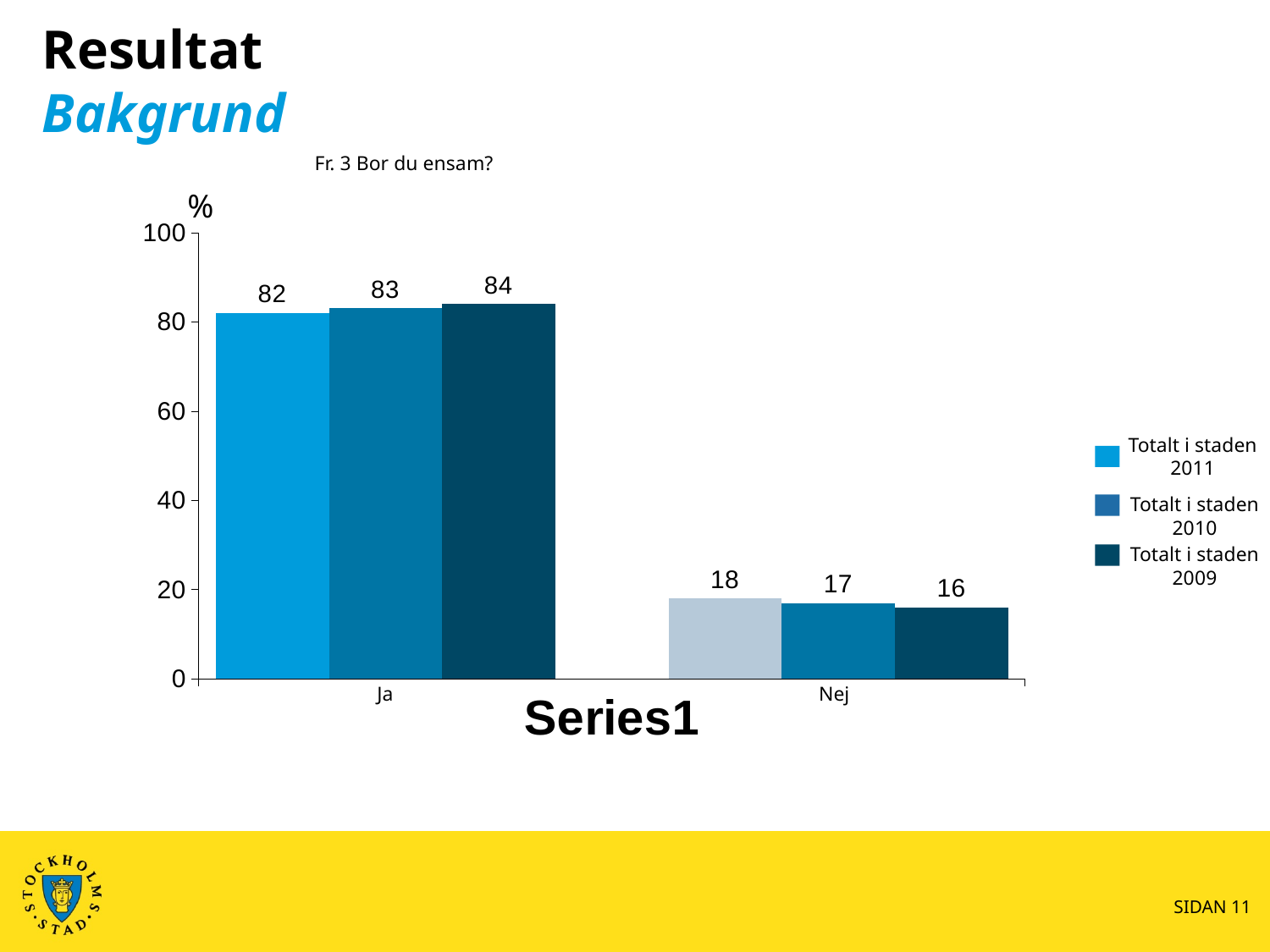
How many categories are shown on the x axis? 2 What is the title of the chart? Fr. 3 Bor du ensam? Which is larger: the "Ja" value for "Totalt i staden 2011" or the "Ja" value for "Totalt i staden 2009"? Totalt i staden 2009 What is the value for "Ja" in the "Totalt i staden 2010" series? 83 What kind of chart is shown on the slide? Bar chart What is the value for "Nej" in the "Totalt i staden 2009" series? 16 Which series has the lowest value for "Nej"? Totalt i staden 2009 What is the value for "Ja" in the "Totalt i staden 2011" series? 82 Which series has the highest value for "Ja"? Totalt i staden 2009 What is the value for "Nej" in the "Totalt i staden 2011" series? 18 How many series does the legend list? 3 What is the difference between the "Ja" and "Nej" values in the "Totalt i staden 2011" series? 64